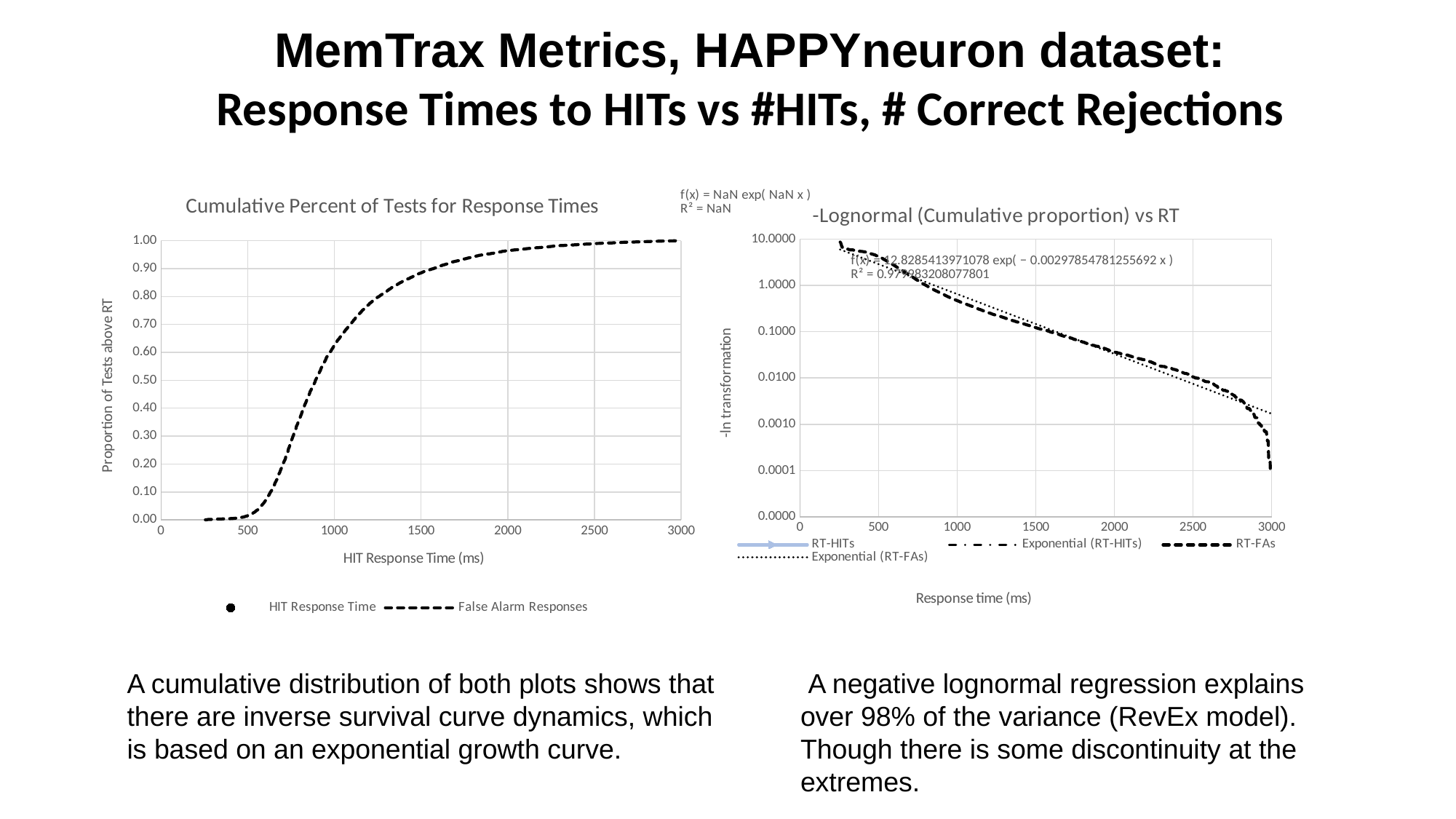
How many series does the legend of the '-Lognormal (Cumulative proportion) vs RT' chart list? 4 In the '-Lognormal (Cumulative proportion) vs RT' chart, do the values rise or fall as response time increases? fall What is the y-axis label of the '-Lognormal (Cumulative proportion) vs RT' chart? -ln transformation In the 'Cumulative Percent of Tests for Response Times' chart, do the values rise or fall as HIT Response Time increases? rise In the '-Lognormal (Cumulative proportion) vs RT' chart, is the value at 2000 ms greater or less than 0.1000? less How many series does the legend of the 'Cumulative Percent of Tests for Response Times' chart list? 2 What is the x-axis label of the 'Cumulative Percent of Tests for Response Times' chart? HIT Response Time (ms) In the 'Cumulative Percent of Tests for Response Times' chart, is the value at 1500 ms greater or less than 0.80? greater In the '-Lognormal (Cumulative proportion) vs RT' chart, is the value at 500 ms greater or less than 1.0000? greater What kind of chart is the 'Cumulative Percent of Tests for Response Times' chart? line chart